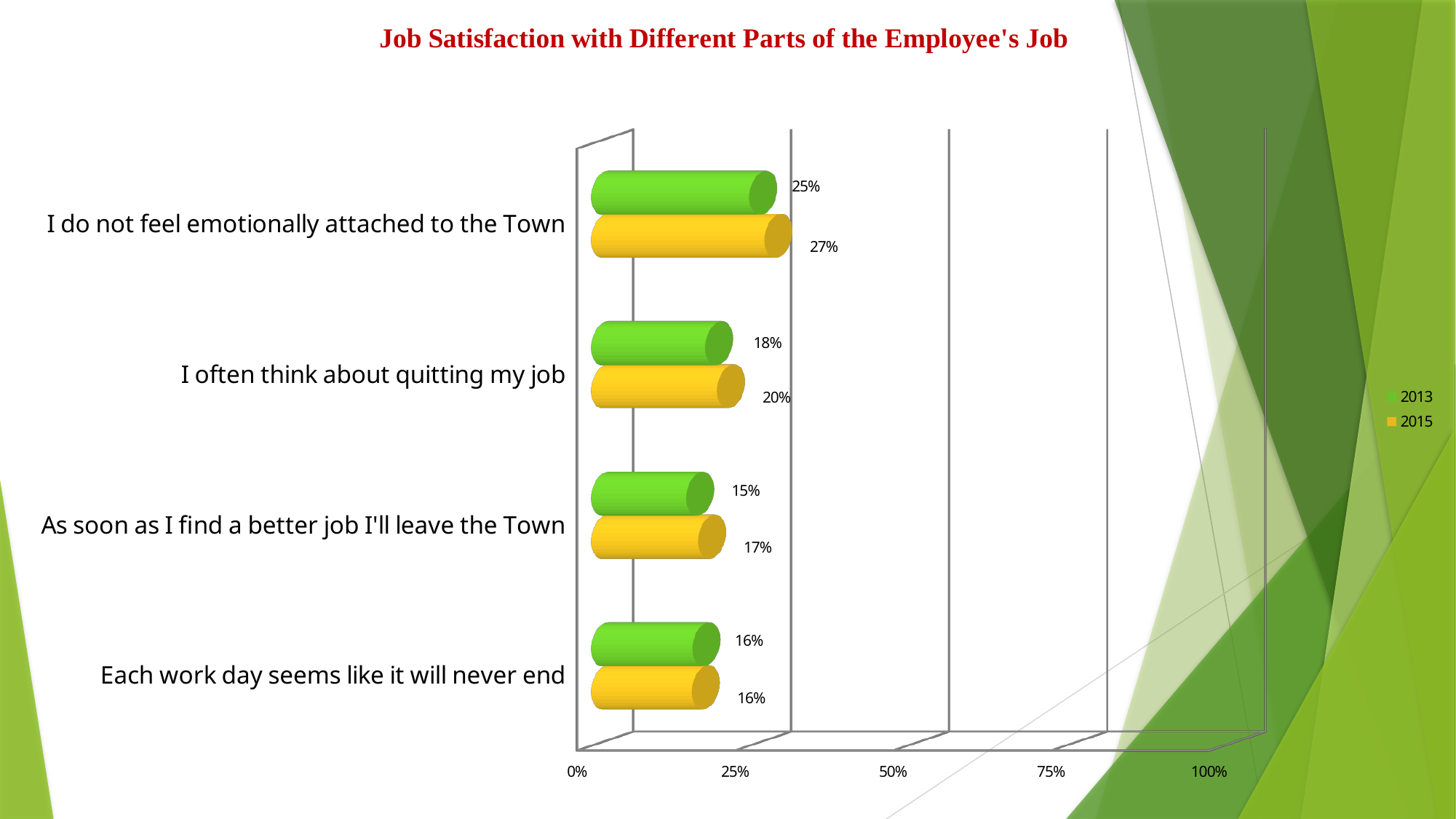
What is the 2013 value for "I often think about quitting my job"? 18% Which category has the highest 2015 value? I do not feel emotionally attached to the Town What is the title of the chart? Job Satisfaction with Different Parts of the Employee's Job What is the difference between the 2015 and 2013 values for "I do not feel emotionally attached to the Town"? 2% Which category has the lowest 2013 value? As soon as I find a better job I'll leave the Town How many categories are shown on the chart? 4 What is the 2015 value for "I do not feel emotionally attached to the Town"? 27% How many series does the legend list? 2 Which is larger for "I often think about quitting my job": the 2013 value or the 2015 value? 2015 What is the 2013 value for "Each work day seems like it will never end"? 16% What kind of chart is shown on the slide? Bar chart What is the 2015 value for "As soon as I find a better job I'll leave the Town"? 17%